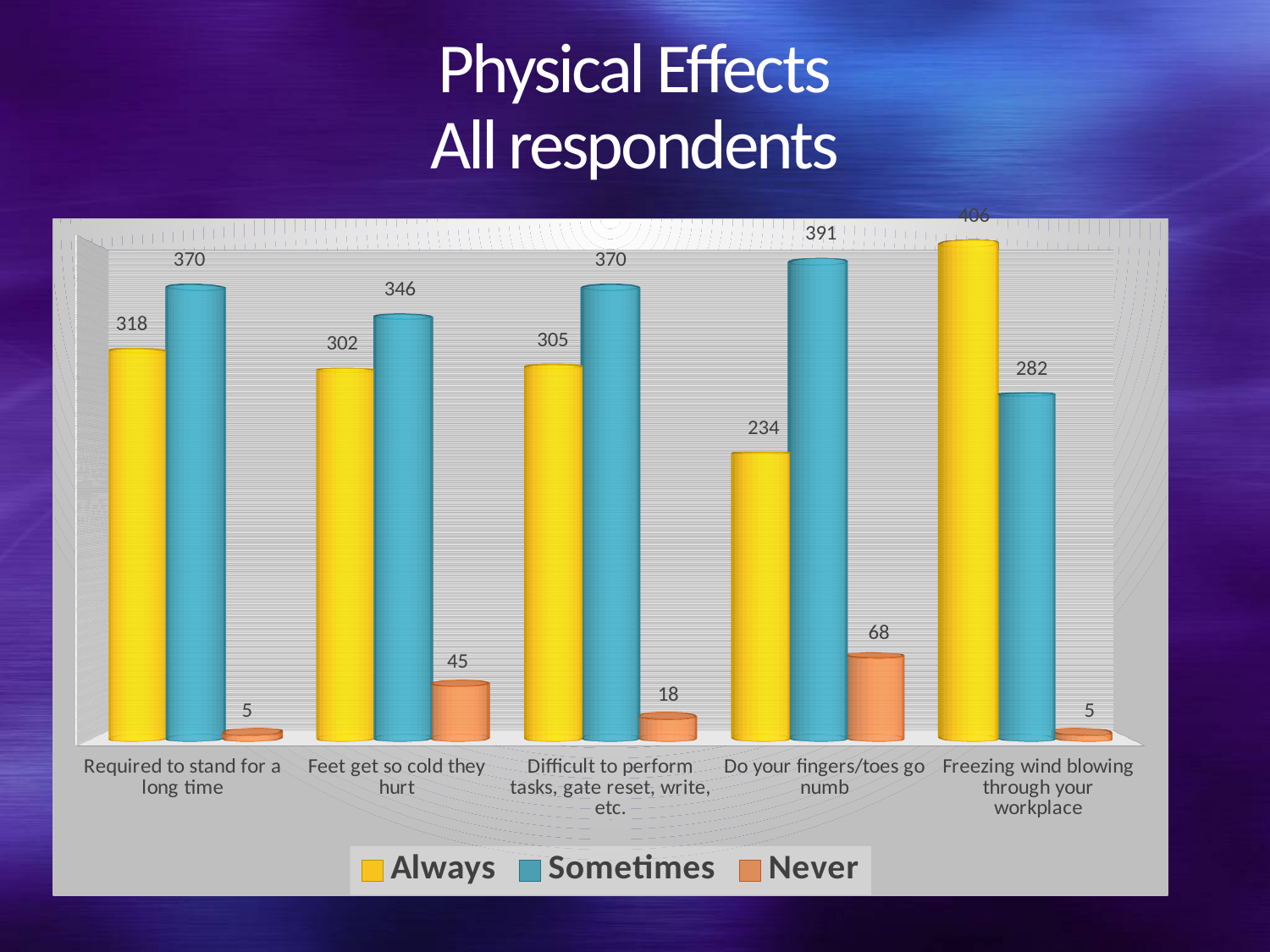
Which category has the lowest 'Sometimes' value? Freezing wind blowing through your workplace How many series does the legend list? 3 Which category has the highest 'Never' value? Do your fingers/toes go numb How many categories are shown on the x axis? 5 What is the 'Never' value for 'Feet get so cold they hurt'? 45 Which is larger for 'Feet get so cold they hurt': the 'Always' value or the 'Sometimes' value? Sometimes What is the title of the chart? Physical Effects All respondents What kind of chart is shown on the slide? Bar chart What is the 'Always' value for 'Required to stand for a long time'? 318 What is the difference between the 'Sometimes' and 'Always' values for 'Do your fingers/toes go numb'? 157 Which category has the highest 'Always' value? Freezing wind blowing through your workplace What is the 'Sometimes' value for 'Do your fingers/toes go numb'? 391